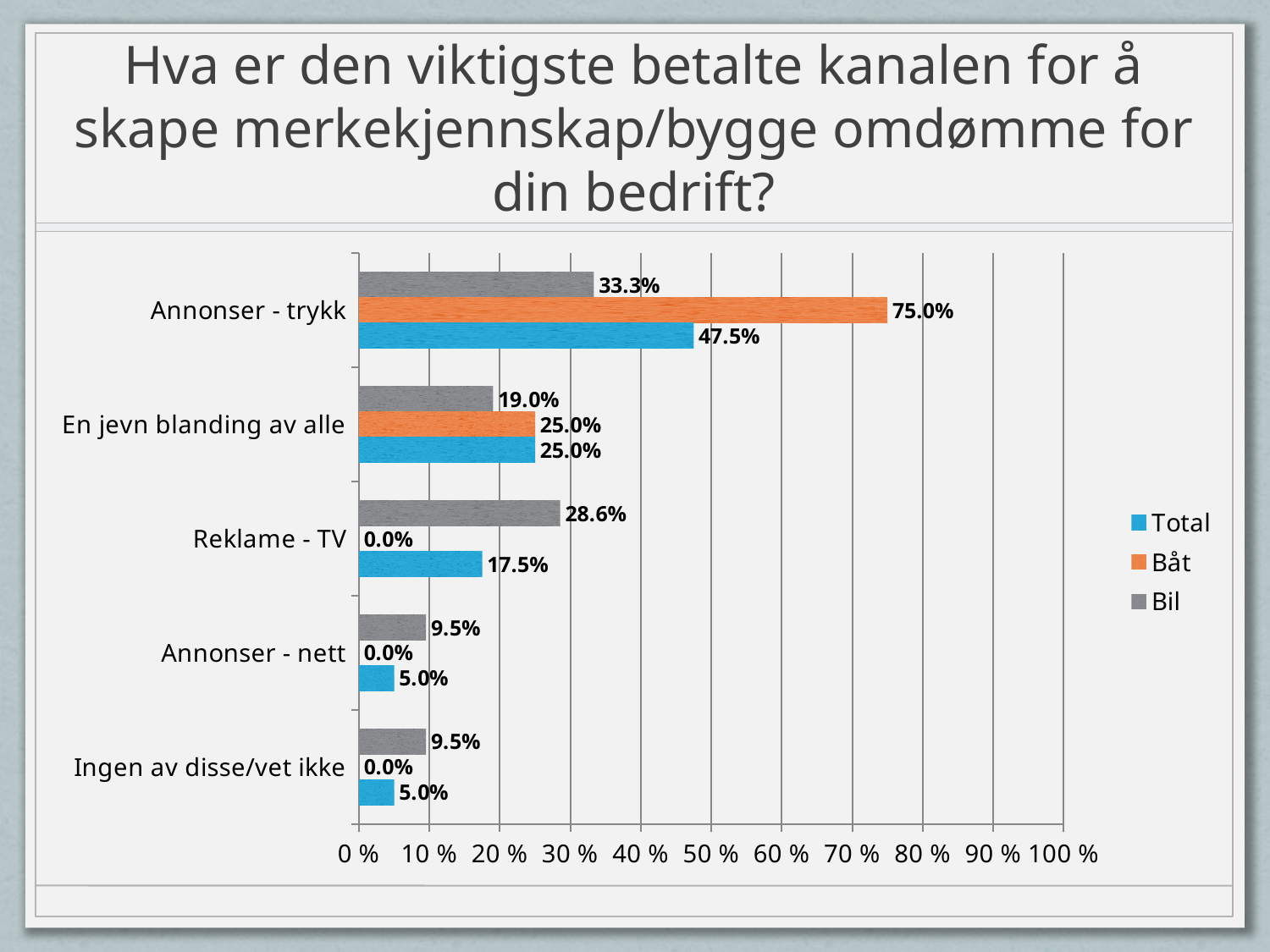
What is the Båt value for Annonser - trykk? 75.0% Which series is shown in orange in the legend? Båt Which category has the highest Total value? Annonser - trykk What is the Total value for Reklame - TV? 17.5% What is the difference between the Båt and Bil values for Annonser - trykk? 41.7 percentage points For Reklame - TV, which is larger: the Bil value or the Total value? Bil Which category has the lowest Bil value? Annonser - nett and Ingen av disse/vet ikke (both 9.5%) Is the Total value for Annonser - trykk greater or less than 40 %? greater How many series does the legend list? 3 What kind of chart is shown on the slide? Bar chart What is the Bil value for En jevn blanding av alle? 19.0% How many categories are shown on the y axis? 5